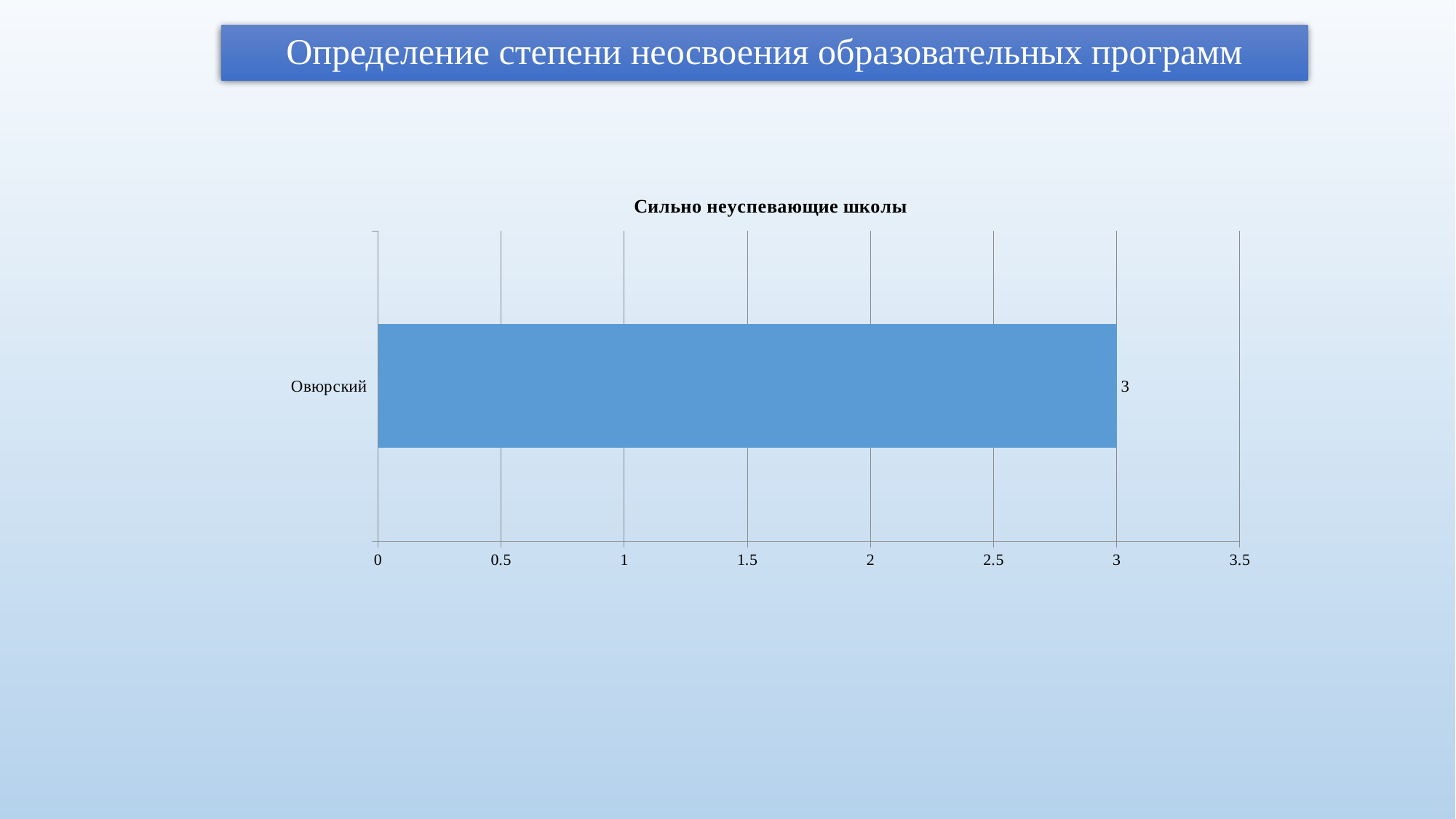
Is the value for Овюрский greater or less than 2? greater What is the title of the chart? Сильно неуспевающие школы How many categories are plotted in the chart? 1 What is the maximum value shown on the x axis of the chart? 3.5 What kind of chart is shown on the slide? bar chart What is the value for Овюрский in the chart? 3 Is the value for Овюрский greater or less than 3.5? less Which category has the highest value in the chart? Овюрский